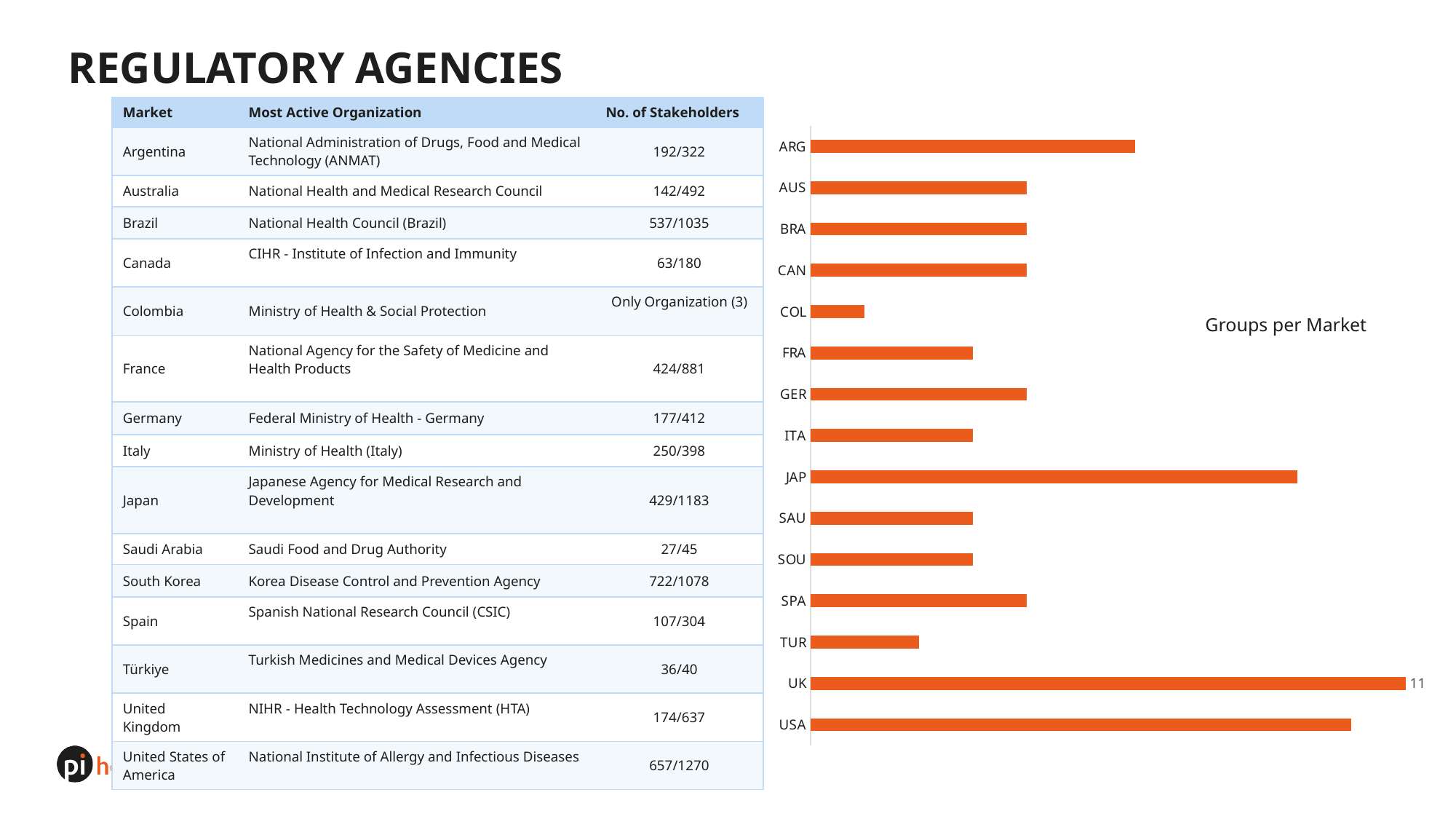
What colour are the bars in the Groups per Market chart? Orange In the Groups per Market chart, which is larger, ARG or AUS? ARG In the Groups per Market chart, which is larger, JAP or FRA? JAP What type of chart is the Groups per Market chart? Bar chart How many markets are shown in the Groups per Market chart? 15 What is the title of the chart on the right of the slide? Groups per Market What is the value for UK in the Groups per Market chart? 11 Which market has the lowest value in the Groups per Market chart? COL In the Groups per Market chart, which is larger, TUR or COL? TUR Which market has the highest value in the Groups per Market chart? UK